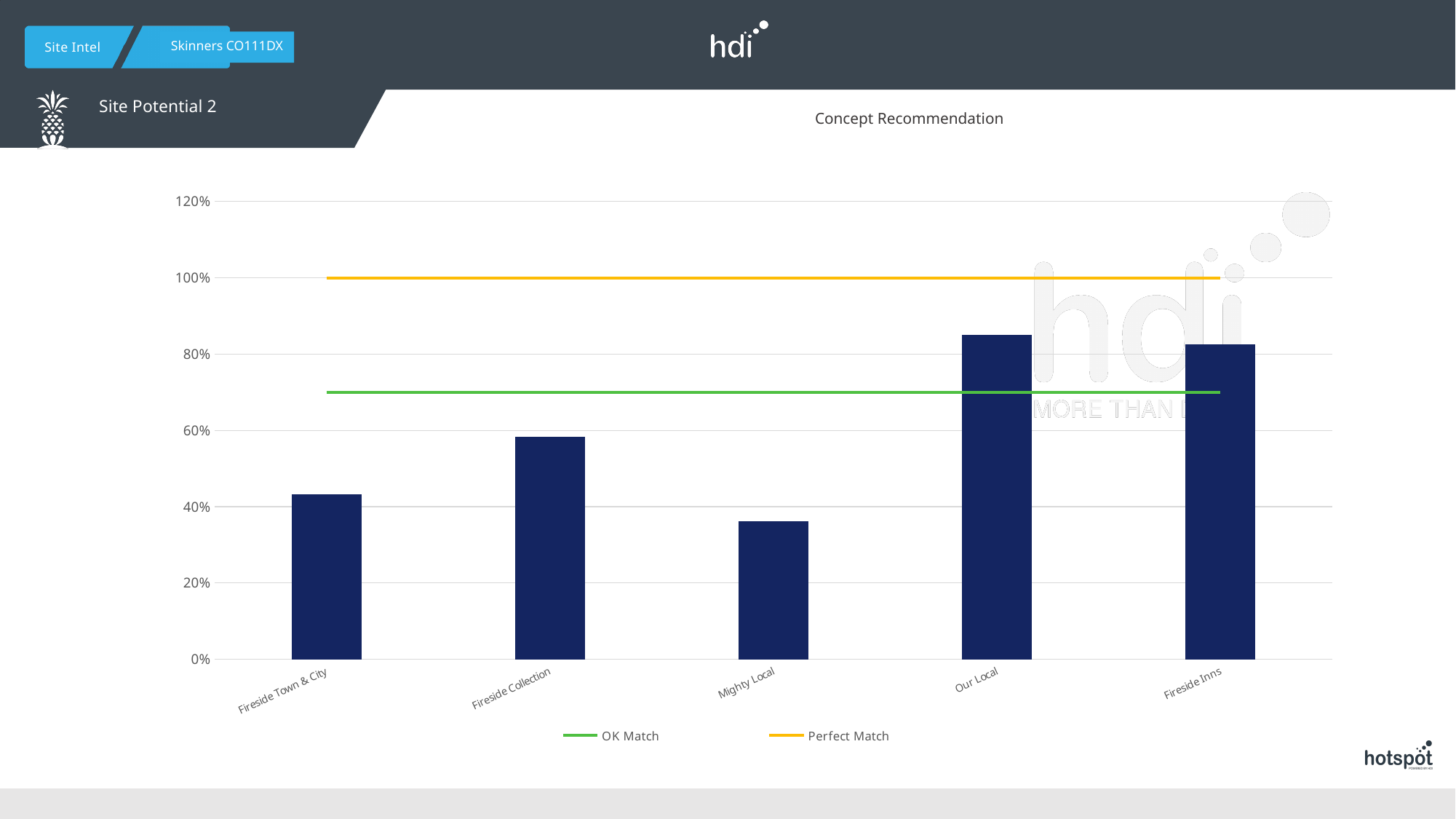
Is the value for Mighty Local greater or less than 40%? less Is the value for Our Local greater or less than 80%? greater How many categories are shown on the x axis of the chart? 5 What kind of chart is shown on the slide? bar chart What is the title of the chart? Concept Recommendation Which is larger, the value for Fireside Collection or the value for Fireside Town & City? Fireside Collection Which legend entry is represented by the yellow line in the chart? Perfect Match Is the value for Fireside Collection greater or less than 60%? less How many entries does the chart's legend list? 2 Which is larger, the value for Our Local or the value for Mighty Local? Our Local Which category has the lowest bar in the chart? Mighty Local